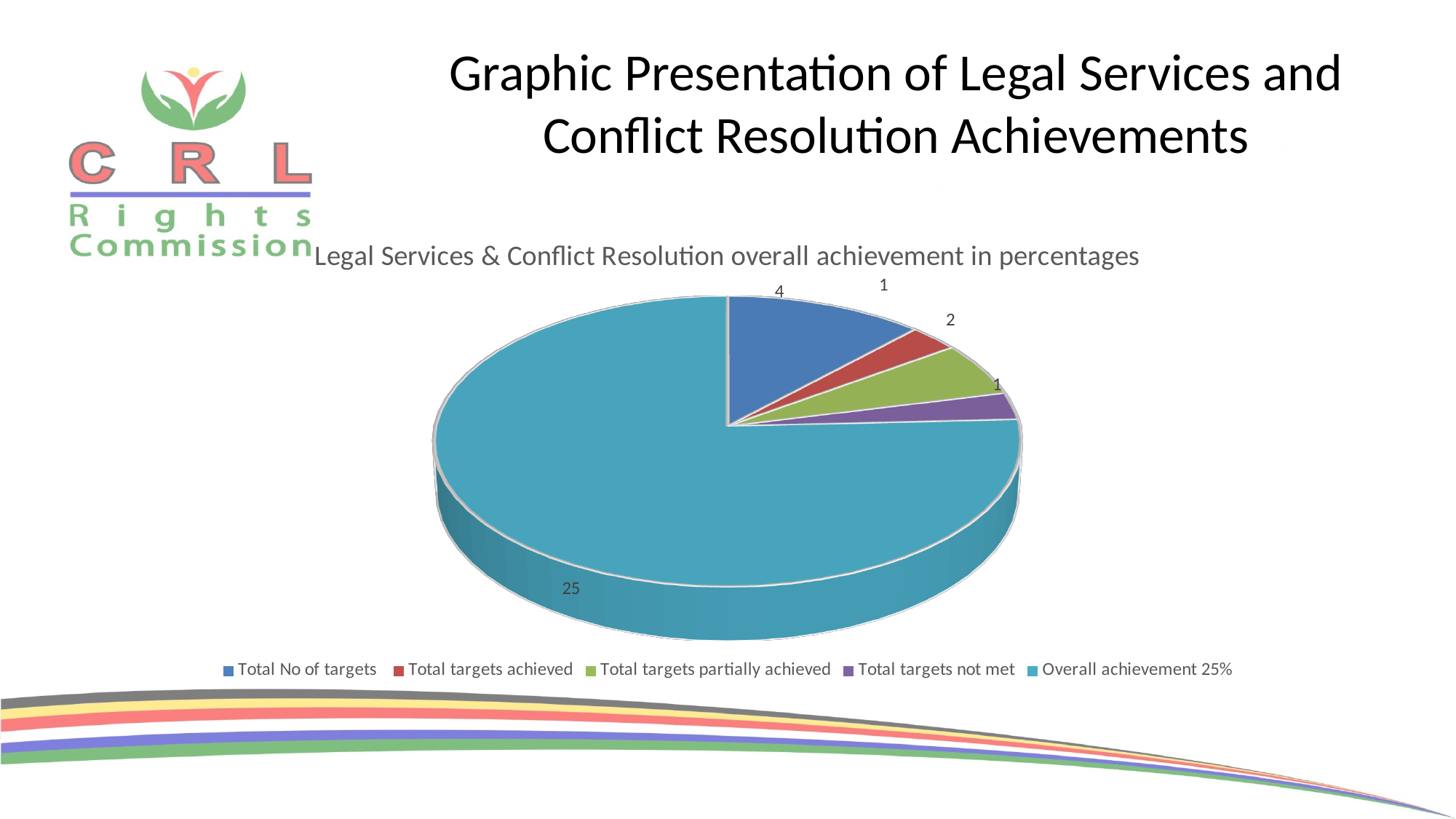
How many slices does the pie chart have? 5 What is the value shown for Total targets achieved? 1 Which is larger, Total No of targets or Total targets partially achieved? Total No of targets What kind of chart is shown on the slide? Pie chart Which slice of the pie chart is the largest? Overall achievement 25% What is the value shown for Total No of targets? 4 What is the value shown for the Overall achievement 25% slice? 25 What is the sum of all the values shown on the pie chart? 33 How many entries does the legend list? 5 What is the value shown for Total targets partially achieved? 2 What is the difference between the value for Total No of targets and the value for Total targets partially achieved? 2 What is the title of the chart? Legal Services & Conflict Resolution overall achievement in percentages